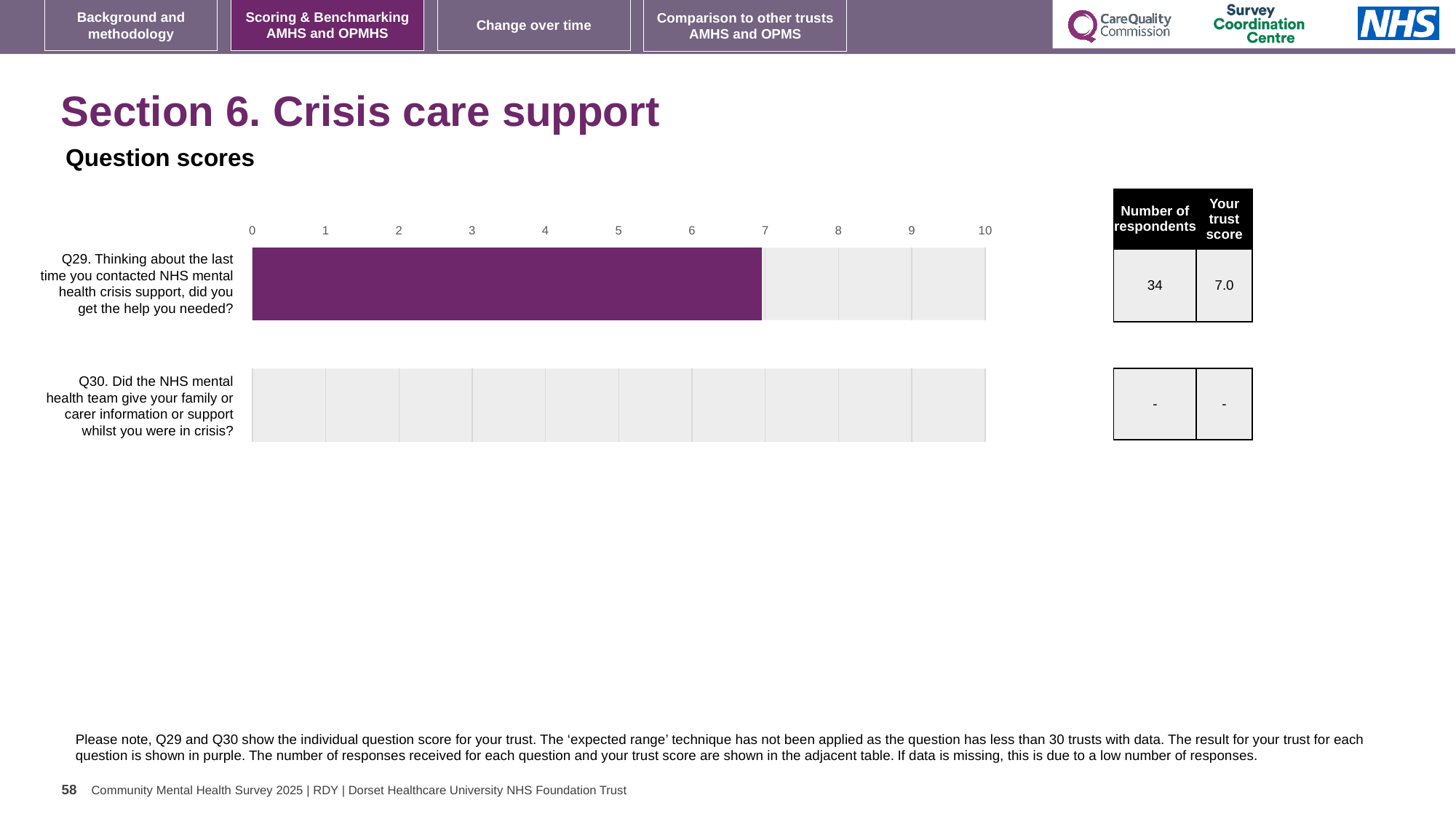
What is the maximum value shown on the chart's axis? 10 What type of chart is shown on the slide? bar chart What colour is used to show the trust's result on the chart? purple How many respondents answered Q29 according to the table? 34 What is the trust score for Q29 shown in the adjacent table? 7.0 Which question has a purple bar plotted on the chart? Q29 Which question has no bar plotted on the chart? Q30 Is the value for Q29 greater or less than 5? greater How many questions (categories) are listed on the chart? 2 What is shown in the table for the number of respondents for Q30? - Is the value for Q29 greater or less than 8? less